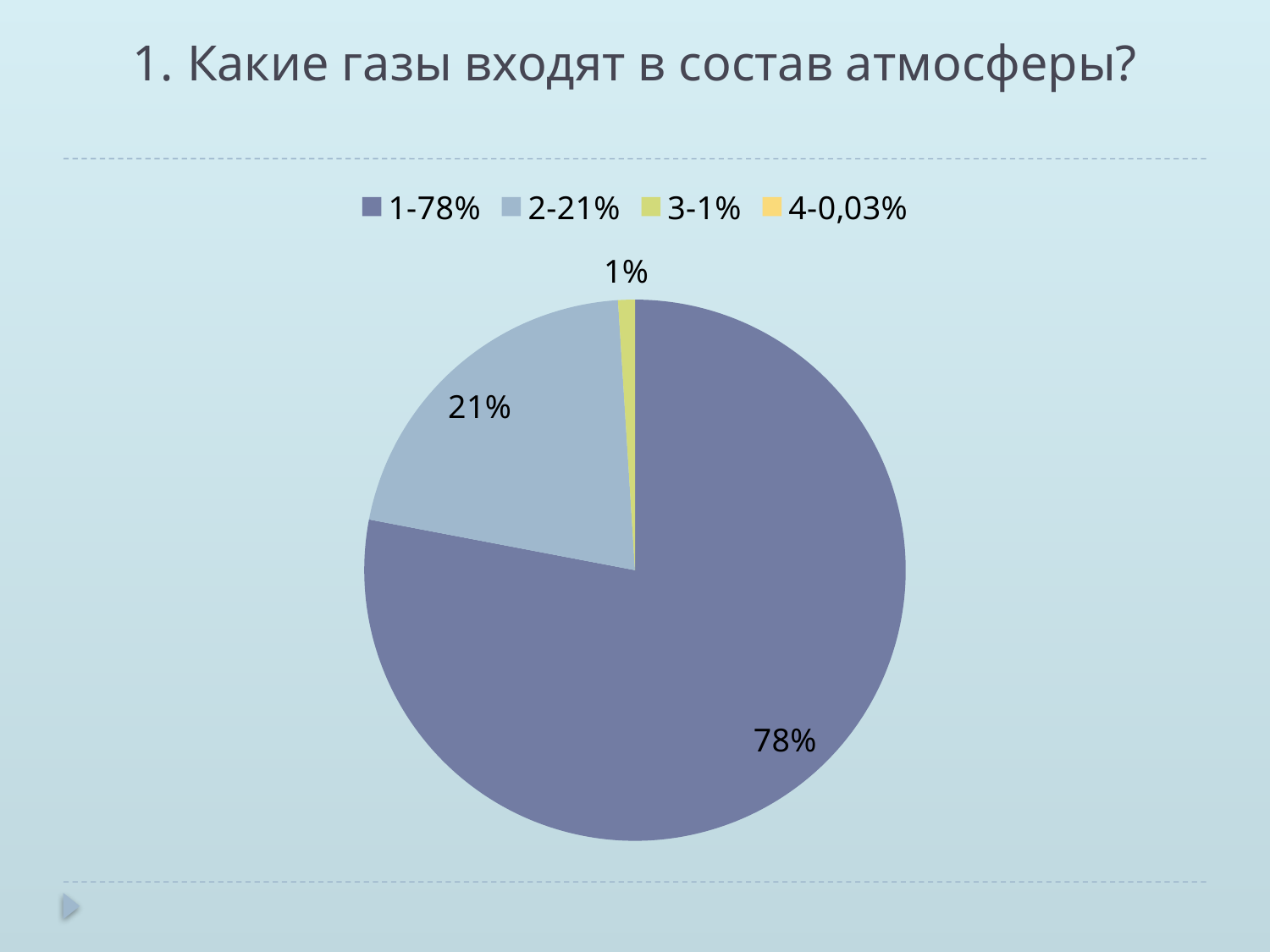
Which legend entry corresponds to the largest slice of the pie? 1-78% What is the data label shown on the largest slice of the pie? 78% Which legend entry corresponds to the smallest share of the pie? 4-0,03% What is the value shown in the legend for the fourth entry? 0,03% What is the data label shown on the yellow-green slice (legend entry "3-1%")? 1% What is the title of the slide containing the pie chart? 1. Какие газы входят в состав атмосферы? Which is larger: the slice for legend entry "2-21%" or the slice for legend entry "3-1%"? 2-21% What kind of chart is shown on the slide? pie chart What is the data label shown on the light blue slice (legend entry "2-21%")? 21% How many entries does the legend list? 4 What share of the pie does the slice for legend entry "1-78%" take? 78% What is the difference between the 78% slice and the 21% slice? 57%